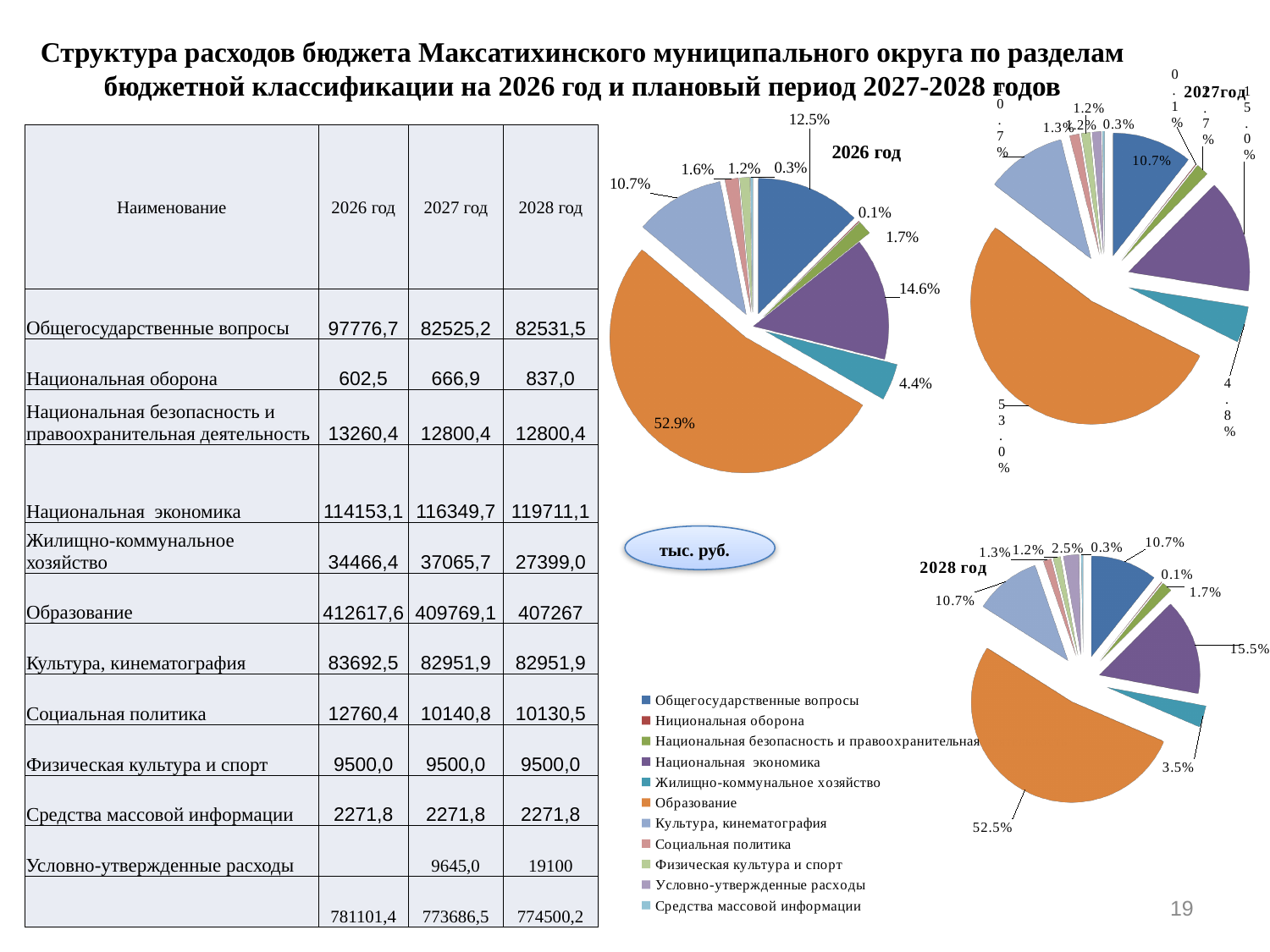
In the 2026 год pie chart, what share does Образование have? 52.9% In the 2028 год pie chart, what share does Национальная экономика have? 15.5% In the 2026 год pie chart, what share does Жилищно-коммунальное хозяйство have? 4.4% In the 2026 год pie chart, what is the difference in percentage points between the Образование slice and the Национальная экономика slice? 38.3 percentage points In the 2026 год pie chart, what share does Общегосударственные вопросы have? 12.5% How many categories does the legend list for the pie charts? 11 In the 2028 год pie chart, what share does Образование have? 52.5% In the 2026 год pie chart, what share does Национальная экономика have? 14.6% What kind of charts are shown on the slide? Pie charts In the 2028 год pie chart, which is larger: the Общегосударственные вопросы slice or the Национальная экономика slice? Национальная экономика In the 2026 год pie chart, which category has the largest slice? Образование How many pie charts are on the slide? 3